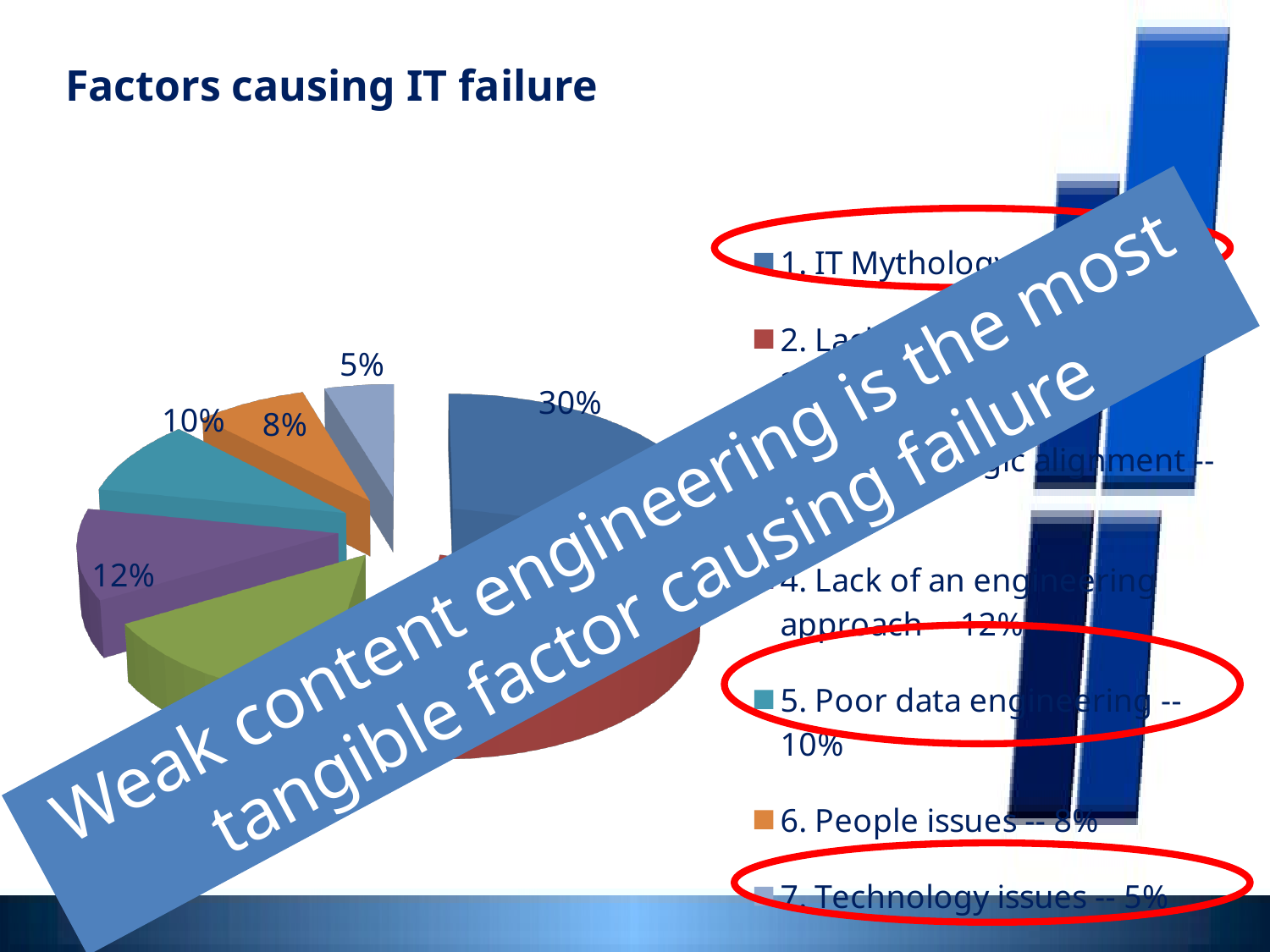
What percentage is shown for 7. Technology issues? 5% Which category has the smallest share of the pie? 7. Technology issues What share of the pie does Technology issues represent? 5% What is the difference in percentage points between Poor data engineering and People issues? 2 How many categories does the legend list? 7 What percentage is shown for 5. Poor data engineering? 10% What percentage is shown for 6. People issues? 8% What percentage is shown for 4. Lack of an engineering approach? 12% What kind of chart is shown on the slide? pie chart What is the difference in percentage points between Lack of an engineering approach and Technology issues? 7 Which is larger, People issues or Technology issues? People issues What is the title of the chart? Factors causing IT failure